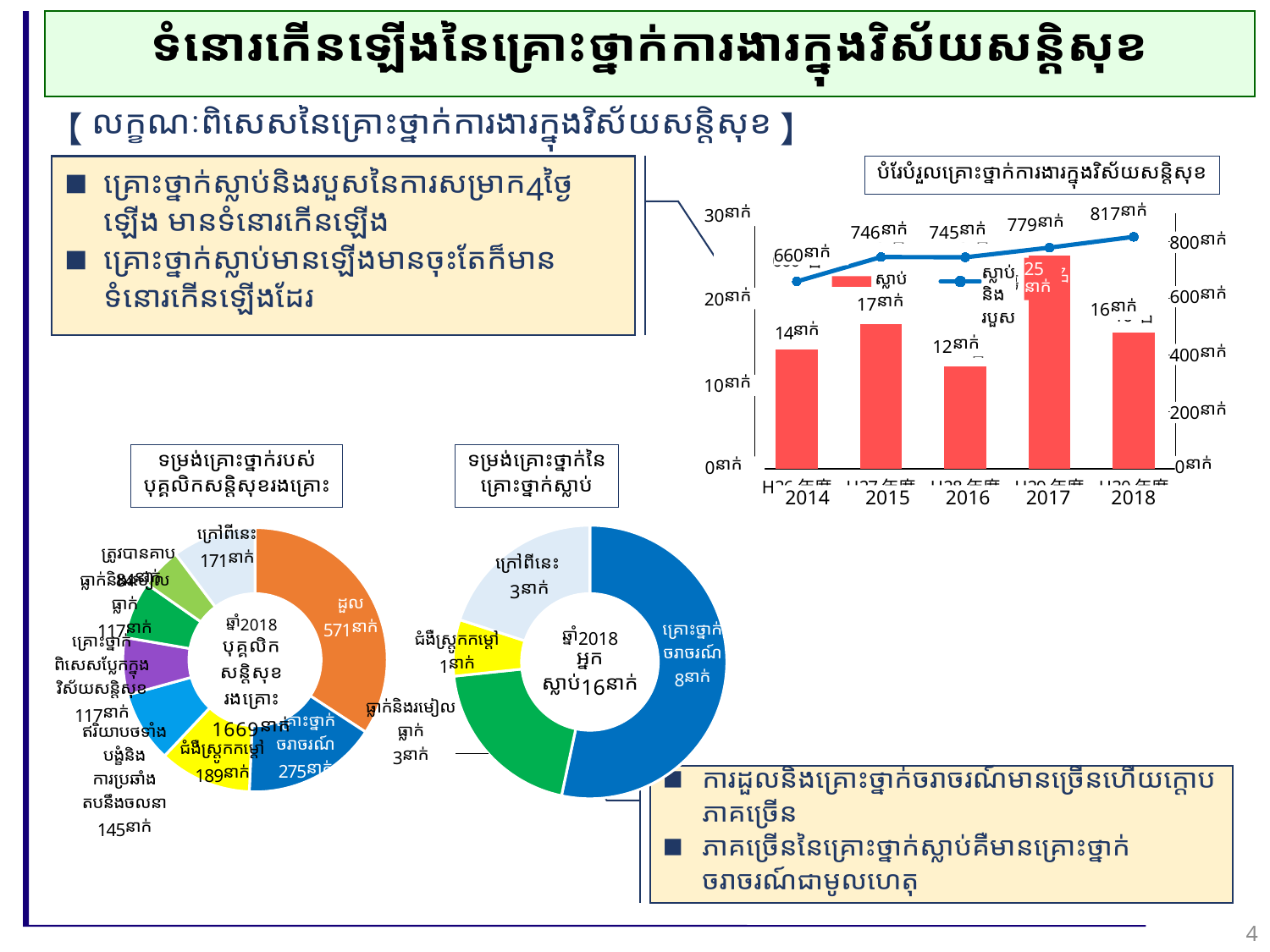
In the bottom-middle donut chart, which category has the largest slice? គ្រោះថ្នាក់ចរាចរណ៍ In the top-right chart, does the ស្លាប់និងរបួស line rise or fall from 2014 to 2018? Rises In the top-right chart, how many years are shown on the x axis? 5 In the top-right chart, what is the value of the blue ស្លាប់និងរបួស line for 2018? 817នាក់ In the top-right chart, what is the difference between the ស្លាប់និងរបួស values for 2018 and 2014? 157នាក់ In the bottom-middle donut chart (ទម្រង់គ្រោះថ្នាក់នៃគ្រោះថ្នាក់ស្លាប់), what is the value for គ្រោះថ្នាក់ចរាចរណ៍? 8នាក់ In the top-right chart, how many series does the legend list? 2 In the top-right chart, which year has the highest red ស្លាប់ bar? 2017 In the bottom-left donut chart (ទម្រង់គ្រោះថ្នាក់របស់បុគ្គលិកសន្តិសុខរងគ្រោះ), what is the value for ដួល? 571នាក់ What kind of chart is the top-right chart? Combined bar and line chart In the top-right chart, which year has the lowest red ស្លាប់ bar? 2016 In the top-right chart (បំរែបំរួលគ្រោះថ្នាក់ការងារក្នុងវិស័យសន្តិសុខ), what is the value of the red ស្លាប់ bar for 2017? 25នាក់